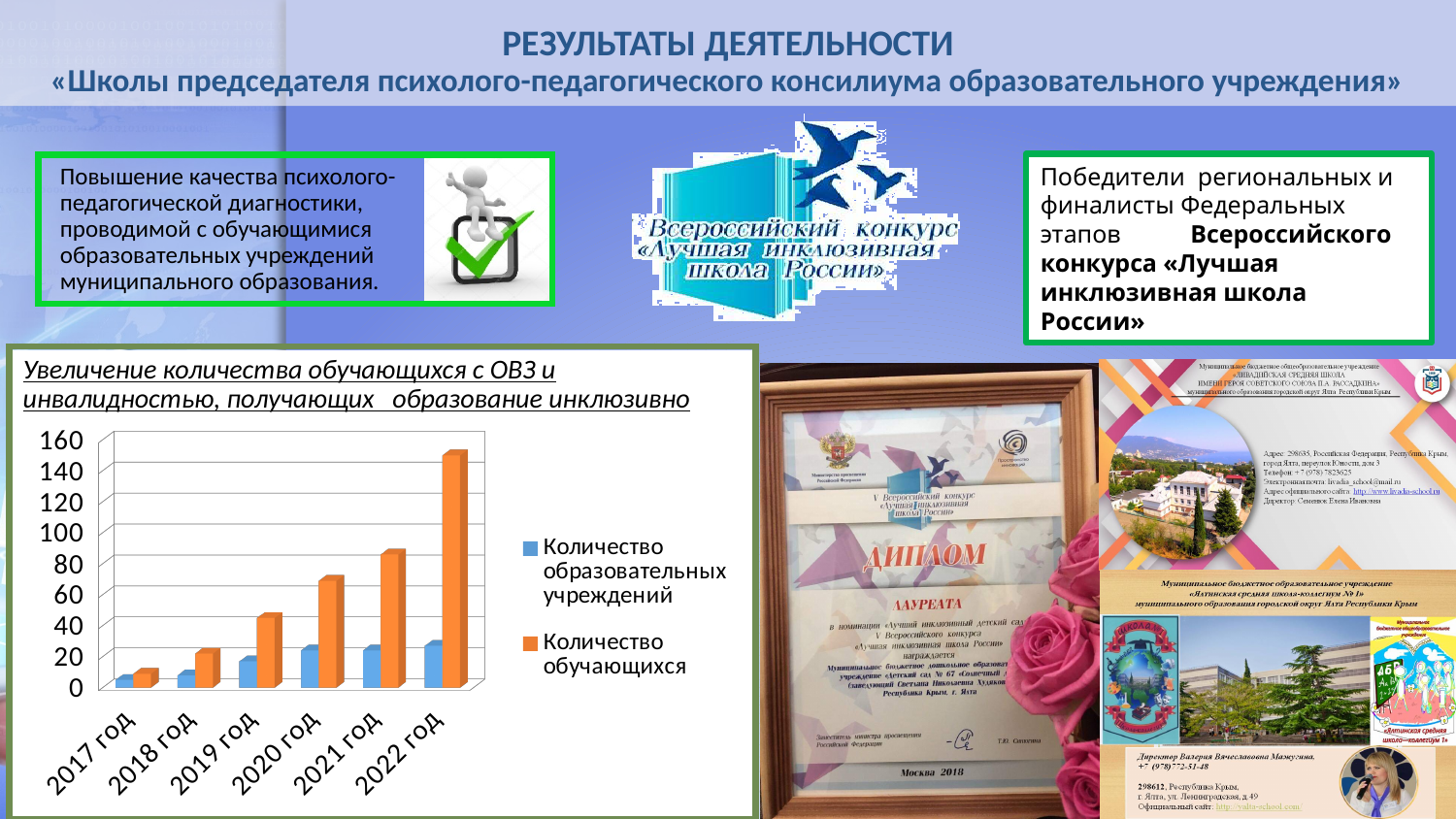
In which year is the value for «Количество обучающихся» lowest? 2017 год In which year is the value for «Количество обучающихся» highest? 2022 год Is the value for «Количество обучающихся» in 2022 год greater or less than 140? greater Is the value for «Количество обучающихся» in 2020 год greater or less than 80? less Do the values for «Количество обучающихся» rise or fall from 2017 год to 2022 год? Rise Which year has the larger value for «Количество обучающихся»: 2021 год or 2022 год? 2022 год Which is larger in 2022 год: «Количество образовательных учреждений» or «Количество обучающихся»? Количество обучающихся How many series does the chart legend list? 2 Is the value for «Количество обучающихся» in 2017 год greater or less than 20? less What kind of chart is shown on the slide? Bar chart How many year categories are shown on the x axis of the chart? 6 What colour represents «Количество обучающихся» in the chart legend? Orange